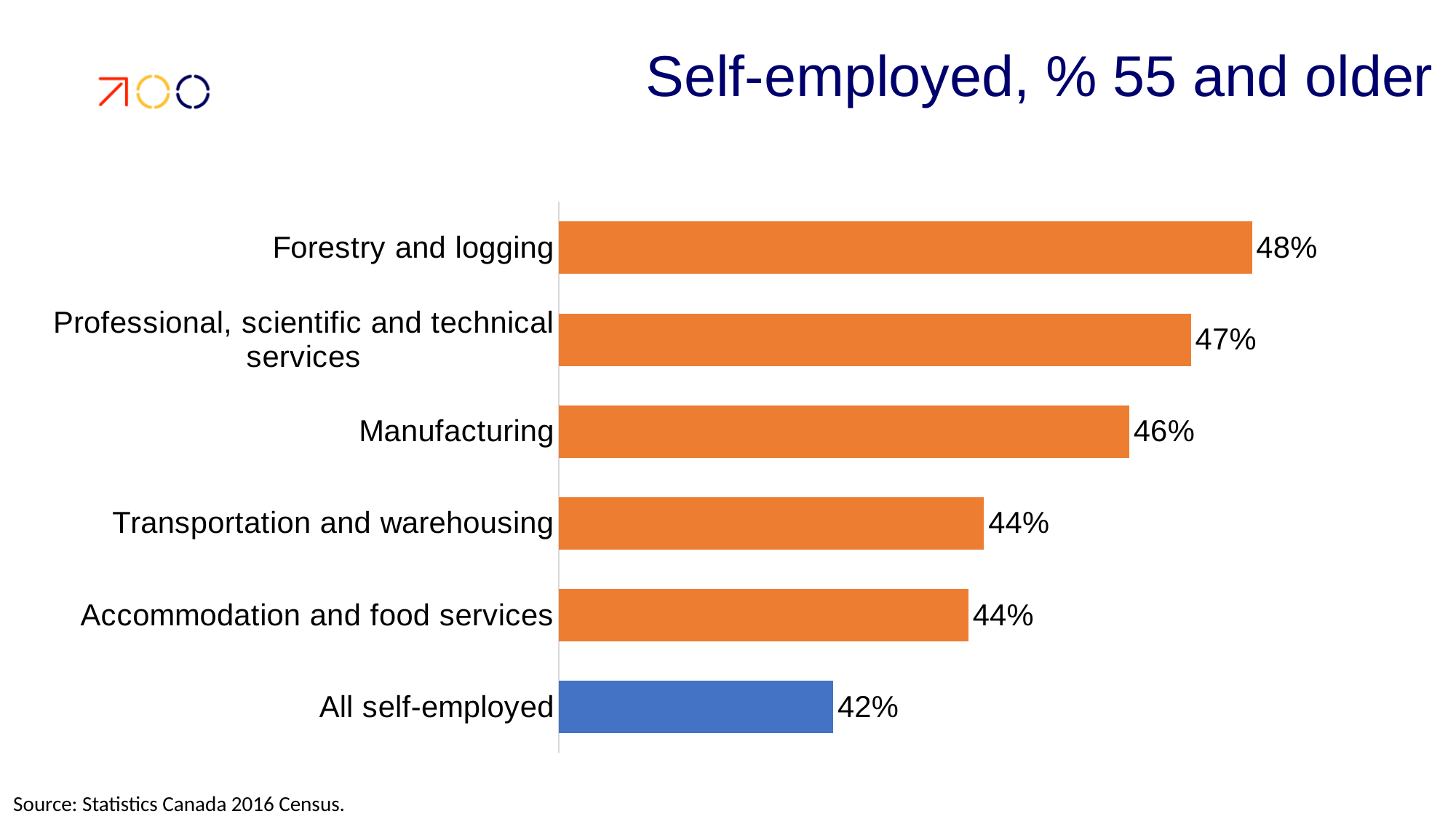
Which category has the lowest value? All self-employed Which is larger, Manufacturing or Accommodation and food services? Manufacturing What is the value for Forestry and logging? 48% What kind of chart is shown on the slide? Bar chart What is the difference between Forestry and logging and All self-employed? 6% What is the value for All self-employed? 42% What is the title of the chart? Self-employed, % 55 and older How many categories are shown in the chart? 6 What is the difference between Manufacturing and Transportation and warehousing? 2% What is the value for Manufacturing? 46% Which category has the highest value? Forestry and logging What is the value for Professional, scientific and technical services? 47%